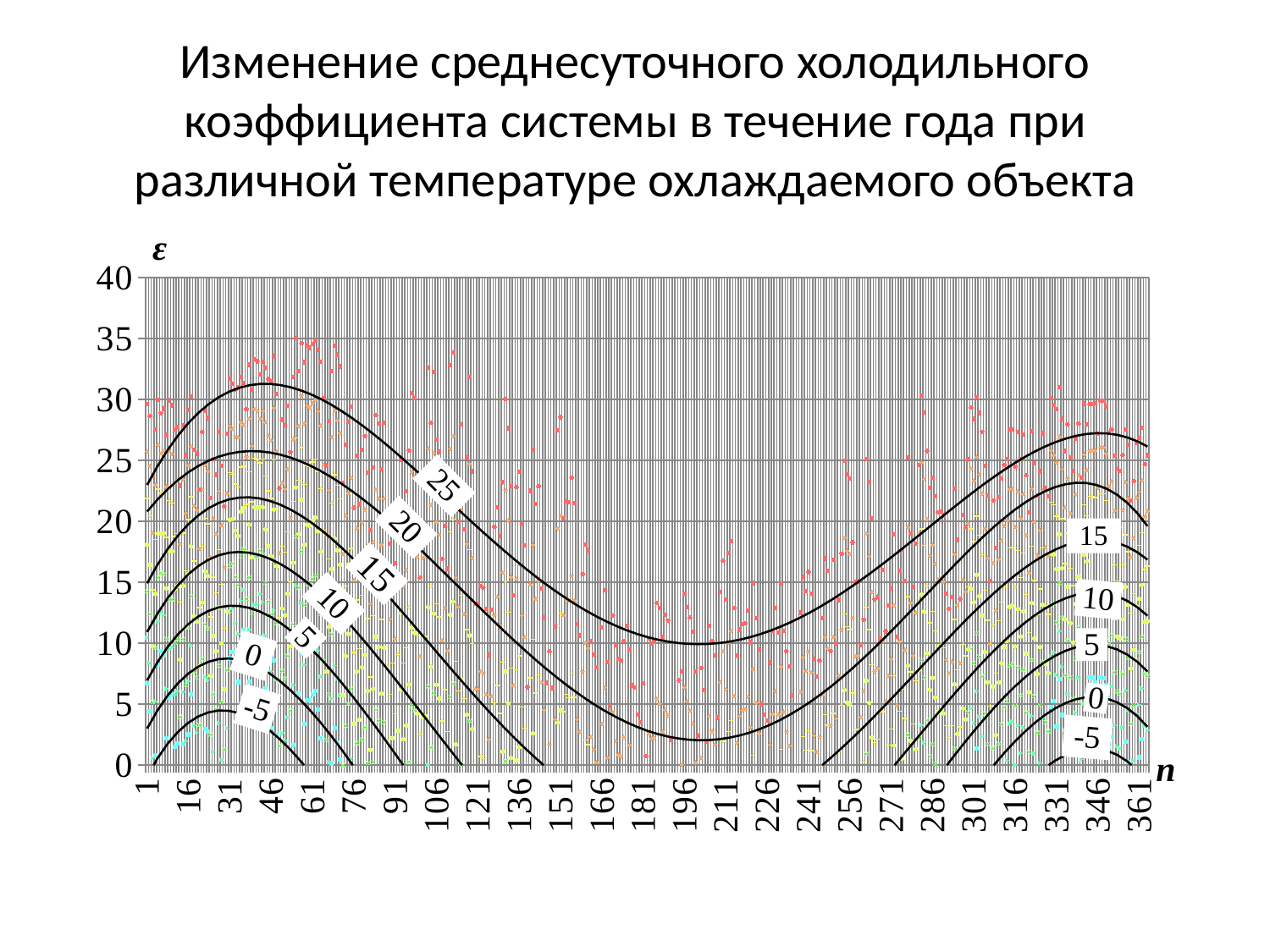
Is the value of the curve labelled 15 near n = 46 greater or less than 20? greater What kind of chart is shown on the slide? line chart Which curve is higher at n = 196, the one labelled 25 or the one labelled 15? 25 How many labelled curves are drawn on the chart? 7 What is the last tick label on the horizontal axis (n) of the chart? 361 Is the value of the curve labelled 25 at its minimum near n = 196 greater or less than 15? less Is the value of the curve labelled 25 near n = 346 greater or less than 25? greater Does the curve labelled 25 rise or fall between n = 46 and n = 196? fall Does the curve labelled 25 rise or fall between n = 196 and n = 346? rise What is the highest value shown on the vertical axis of the chart? 40